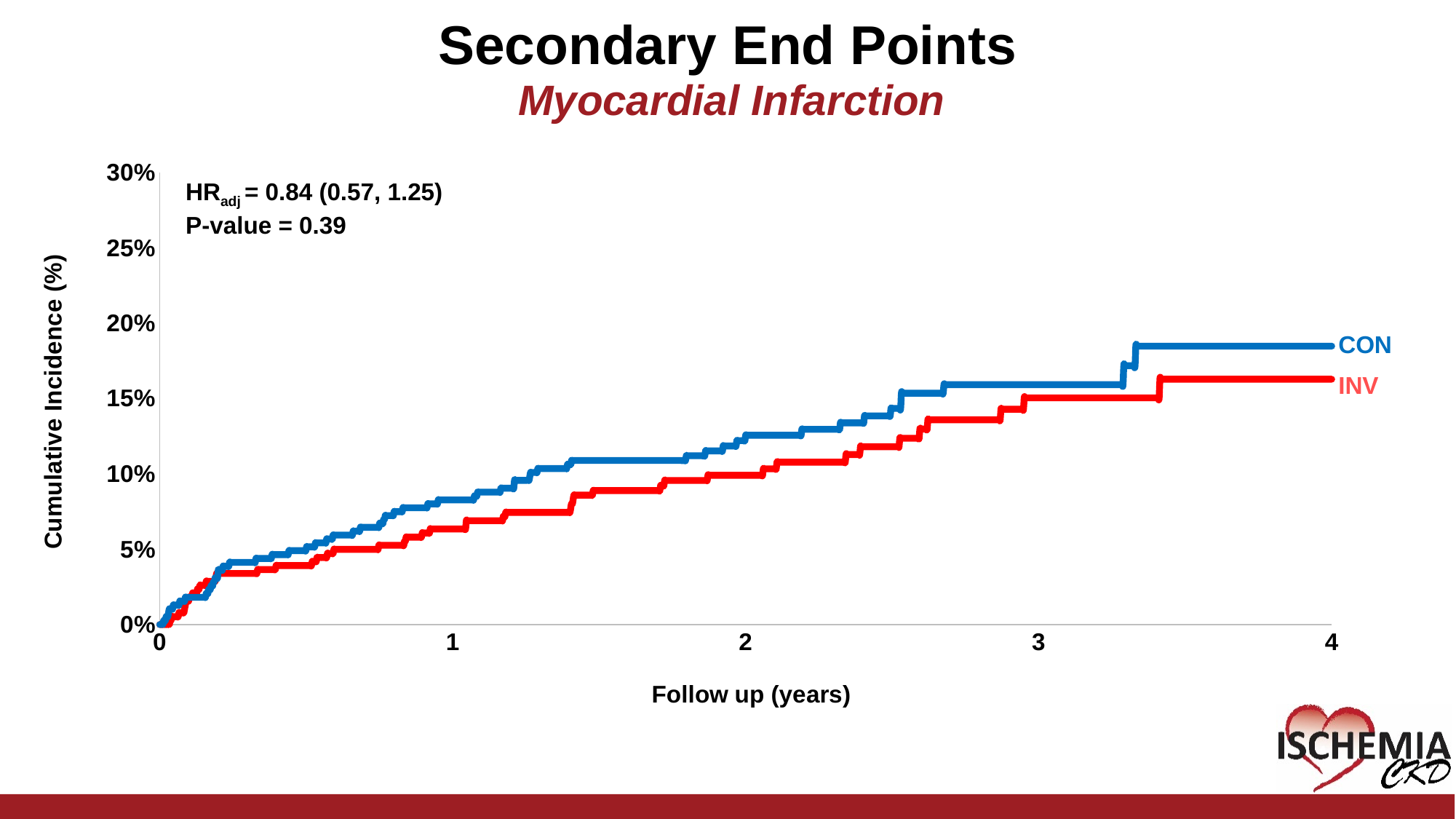
How many series are plotted on the chart? 2 Is the cumulative incidence for CON at 2 years greater or less than 10%? greater Do the cumulative incidence curves rise or fall as follow-up time increases? rise Is the cumulative incidence for CON at 4 years greater or less than 15%? greater At 4 years of follow up, which group has the higher cumulative incidence, CON or INV? CON What adjusted hazard ratio is printed on the chart? 0.84 (0.57, 1.25) Is the cumulative incidence for INV at 1 year greater or less than 10%? less What kind of chart is shown on the slide? line chart Which two groups are plotted on the chart? CON and INV What is the label of the x axis? Follow up (years) At 2 years of follow up, which group has the higher cumulative incidence, CON or INV? CON